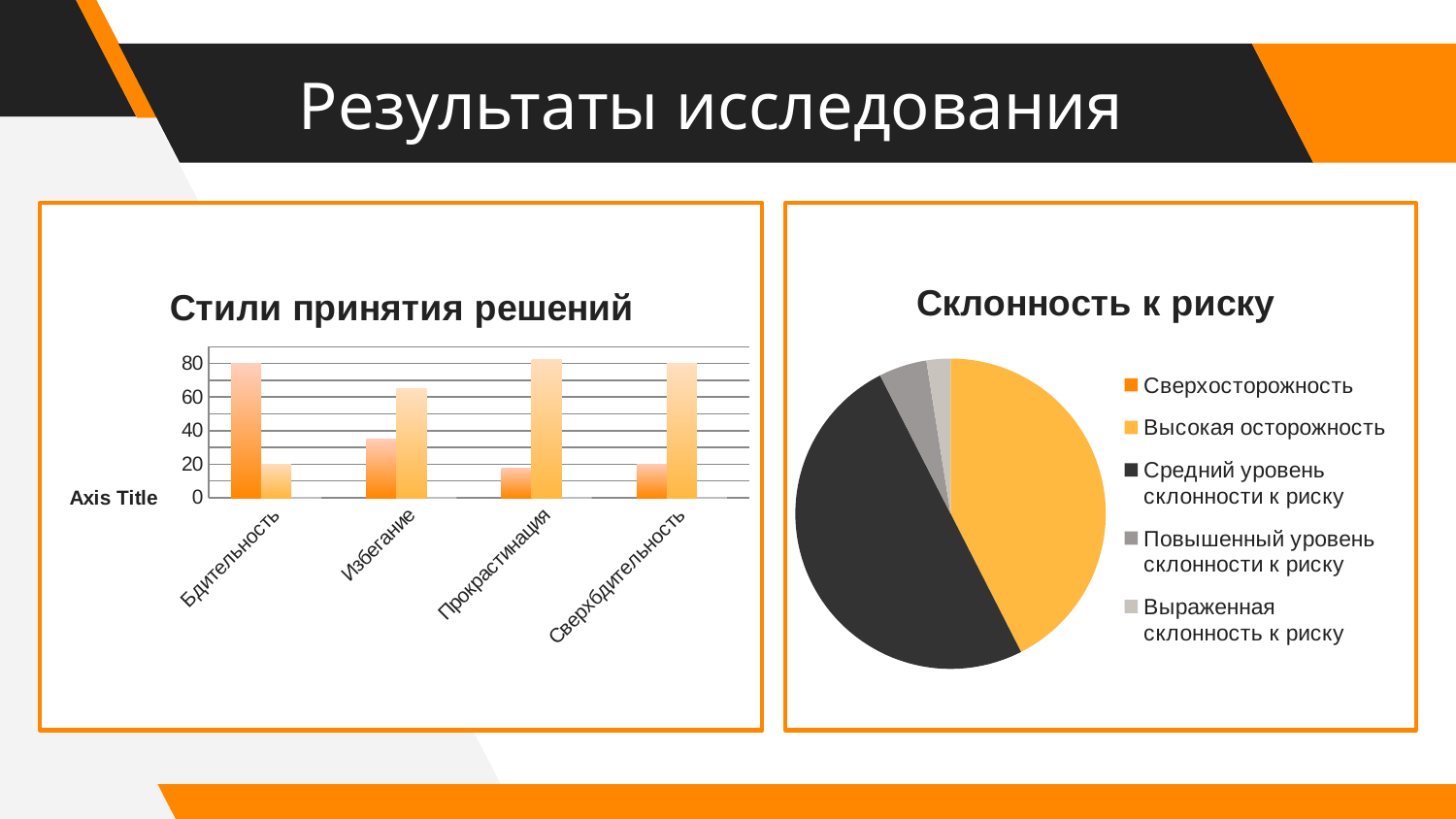
In the chart "Стили принятия решений", is the value of the right (lighter orange) bar for Прокрастинация greater or less than 60? greater In the chart "Стили принятия решений", how many categories are shown on the x axis? 4 In the chart "Склонность к риску", how many entries does the legend list? 5 In the chart "Склонность к риску", which slice is larger: Средний уровень склонности к риску or Повышенный уровень склонности к риску? Средний уровень склонности к риску In the chart "Склонность к риску", which category has the largest slice? Средний уровень склонности к риску In the chart "Стили принятия решений", is the value of the right (lighter orange) bar for Бдительность greater or less than 40? less What is the title of the bar chart on the left of the slide? Стили принятия решений In the chart "Стили принятия решений", is the value of the left (darker orange) bar for Избегание greater or less than 60? less What kind of chart is the chart titled "Стили принятия решений"? bar chart In the chart "Стили принятия решений", for Прокрастинация, which bar is taller, the left or the right one? the right one What kind of chart is the chart titled "Склонность к риску"? pie chart